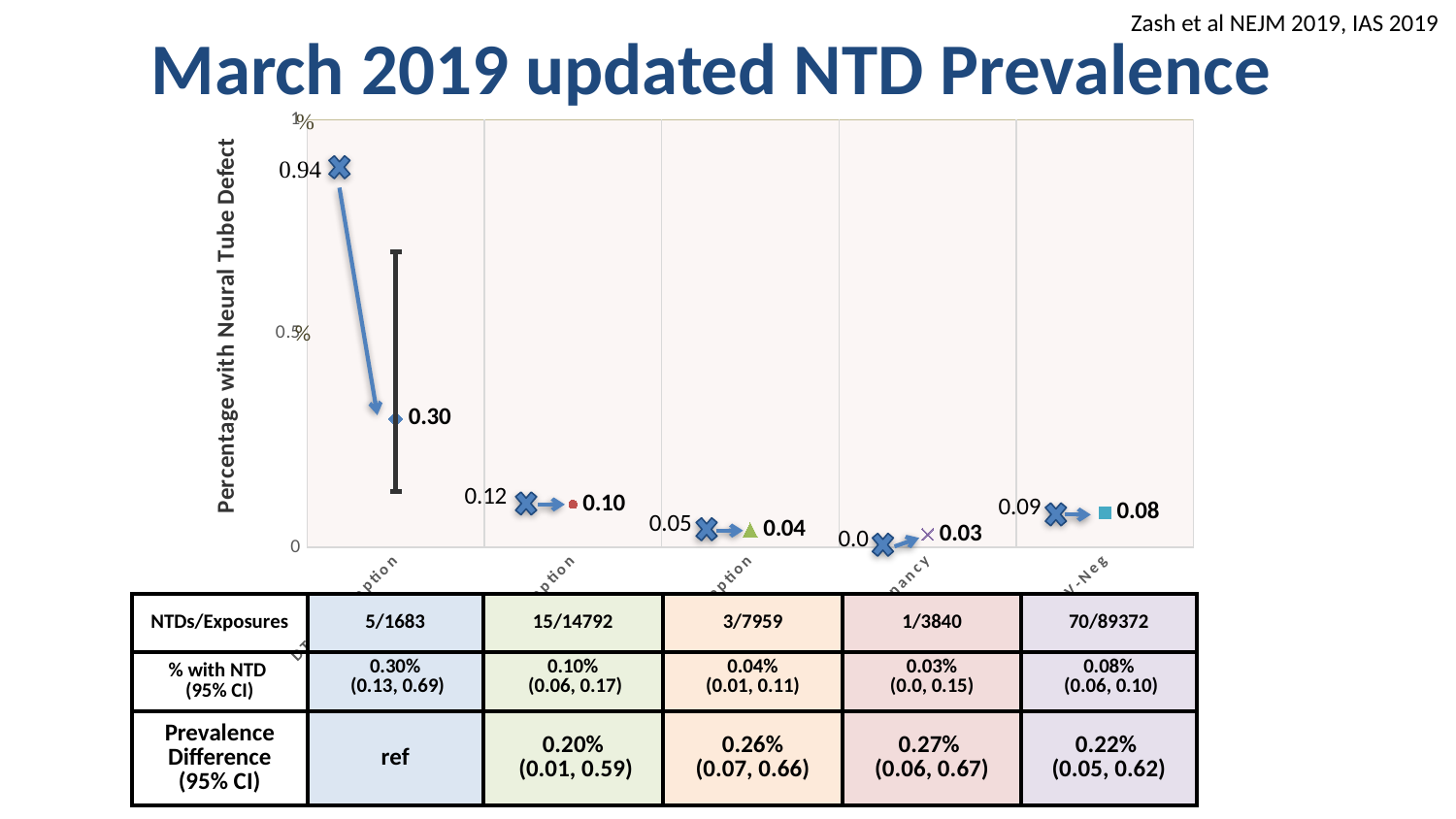
How many categories are plotted along the x axis of the chart? 5 What is the title of the y axis of the chart? Percentage with Neural Tube Defect Is the blue X value for the leftmost category in the chart greater or less than 0.5%? greater In the chart, what is the difference between the blue X value and the updated value for the second category from the left? 0.02 What is the value of the blue X marker for the leftmost category in the chart? 0.94 In the chart, what is the difference between the blue X value (0.94) and the updated value (0.30) for the leftmost category? 0.64 What kind of chart is shown on the slide? scatter chart What is the updated value (the label next to the small marker) for the leftmost category in the chart? 0.30 What is the updated value for the rightmost category in the chart? 0.08 Which category position has the highest updated value in the chart? the leftmost (first) category In the chart, is the updated value for the leftmost category larger or smaller than the updated value for the second category? larger Which category position has the lowest updated value in the chart? the fourth category from the left